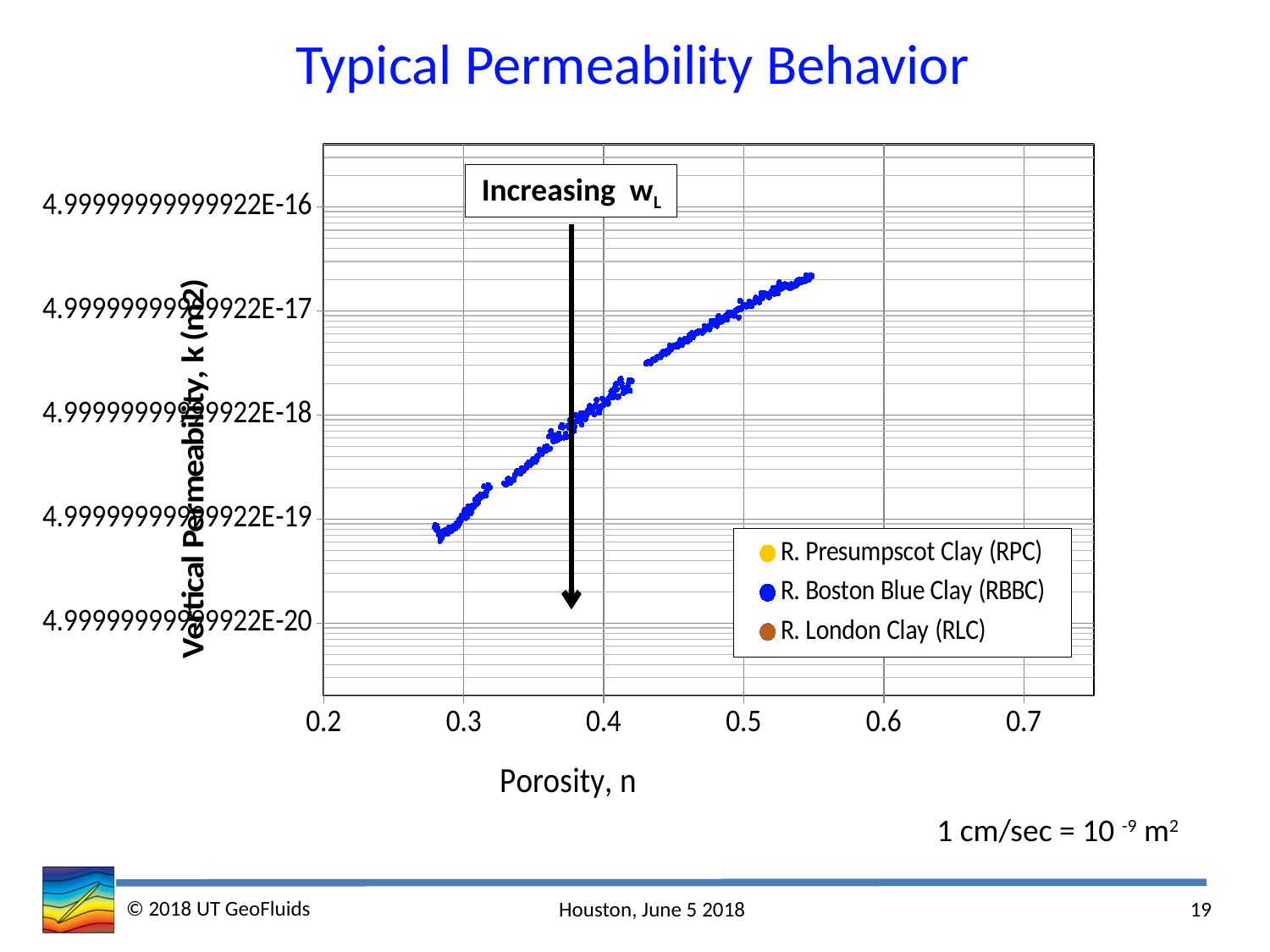
What kind of chart is shown on the slide? scatter chart Is the vertical permeability of R. Boston Blue Clay at a porosity of 0.5 greater or less than 4.99999999999922E-18? greater Is the vertical permeability of R. Boston Blue Clay at a porosity of 0.3 greater or less than 4.99999999999922E-18? less Does vertical permeability rise or fall as porosity increases along the x axis? rise Is the vertical permeability of R. Boston Blue Clay at a porosity of 0.4 greater or less than 4.99999999999922E-17? less How many series does the legend list? 3 Which legend series is plotted with blue points on the chart? R. Boston Blue Clay (RBBC) What is the title of the x axis? Porosity, n